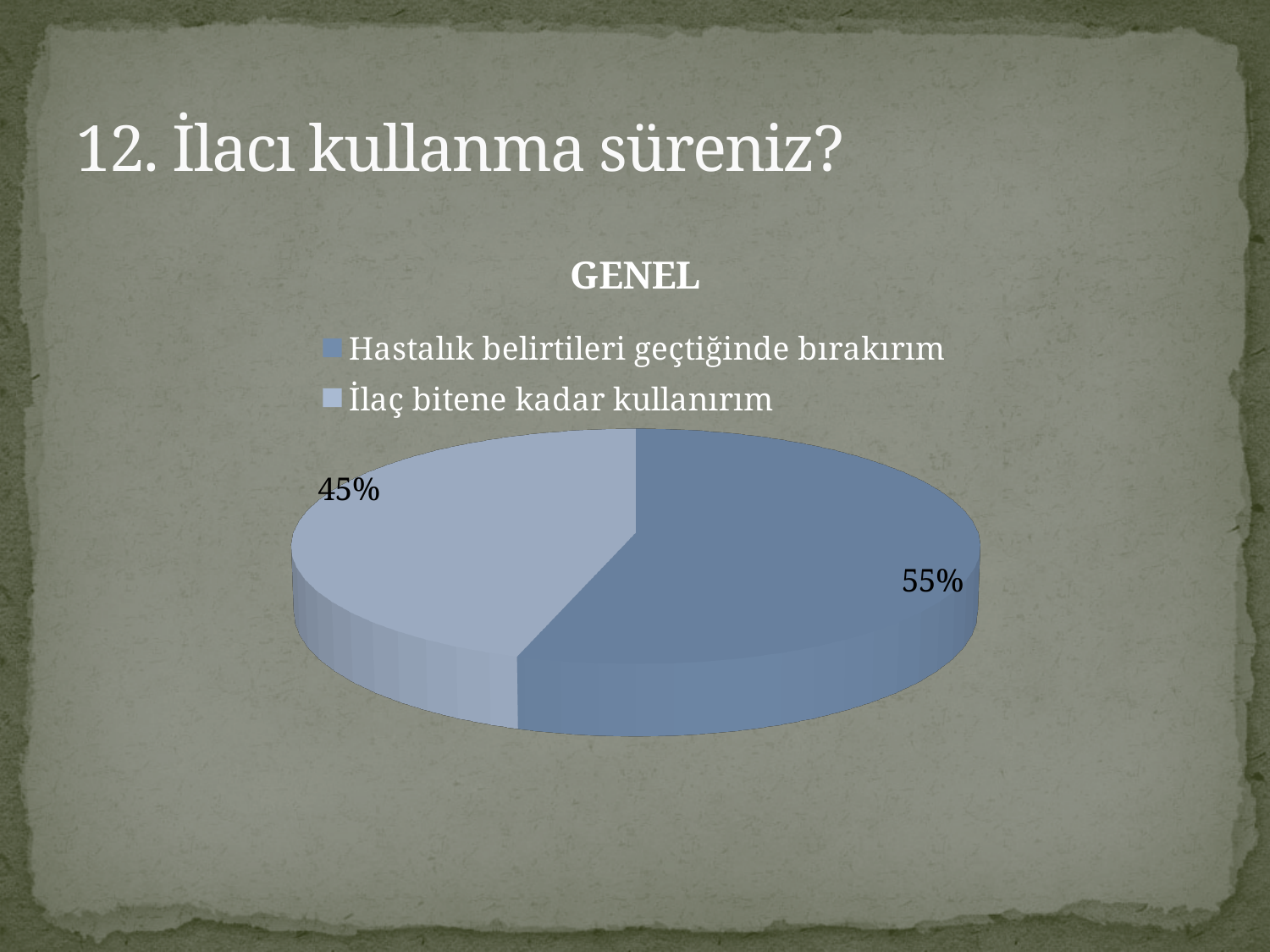
Which category has the largest slice of the pie? Hastalık belirtileri geçtiğinde bırakırım What share of the pie is labelled for "İlaç bitene kadar kullanırım"? 45% Is the share for "İlaç bitene kadar kullanırım" greater or less than 50%? less How many entries does the legend list? 2 What kind of chart is shown on the slide? Pie chart What is the title of the chart? GENEL Which category has the smallest slice of the pie? İlaç bitene kadar kullanırım What is the difference in percentage points between the two slices? 10 What share of the pie is labelled for "Hastalık belirtileri geçtiğinde bırakırım"? 55% Which legend entry is shown in the lighter blue colour? İlaç bitene kadar kullanırım How many slices does the pie chart have? 2 Which is larger: the slice for "İlaç bitene kadar kullanırım" or the slice for "Hastalık belirtileri geçtiğinde bırakırım"? Hastalık belirtileri geçtiğinde bırakırım